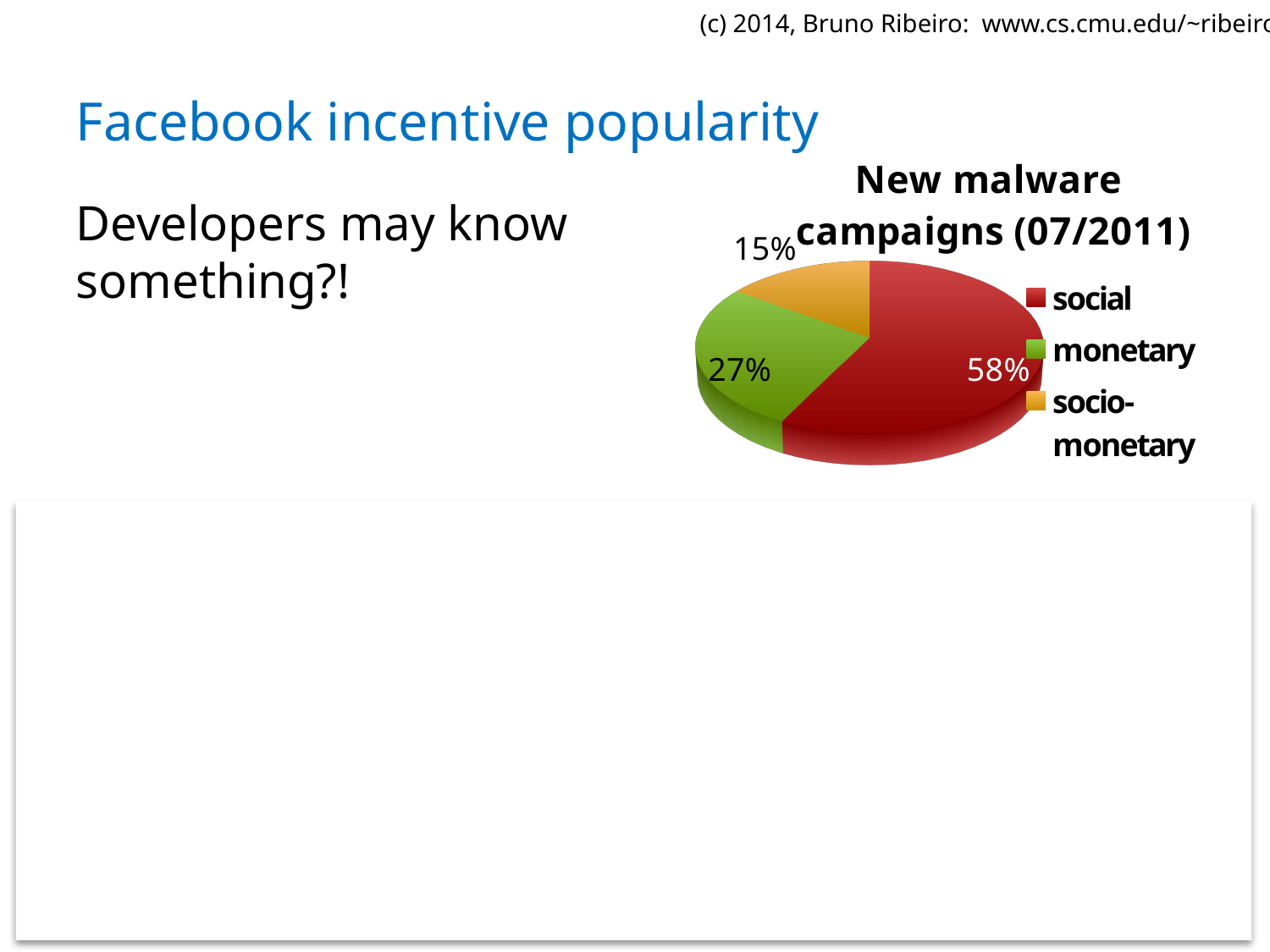
What is the difference in percentage points between the monetary and socio-monetary slices? 12 What share of new malware campaigns is labelled socio-monetary? 15% Which category has the largest slice of the pie? social What share of new malware campaigns is labelled monetary? 27% What kind of chart is shown on the slide? pie chart Which category has the smallest slice of the pie? socio-monetary Which colour represents the monetary category in the legend? green What is the difference in percentage points between the social and monetary slices? 31 What share of new malware campaigns is labelled social? 58% How many categories does the pie chart show? 3 What is the title of the chart? New malware campaigns (07/2011) Which is larger, the monetary slice or the socio-monetary slice? monetary